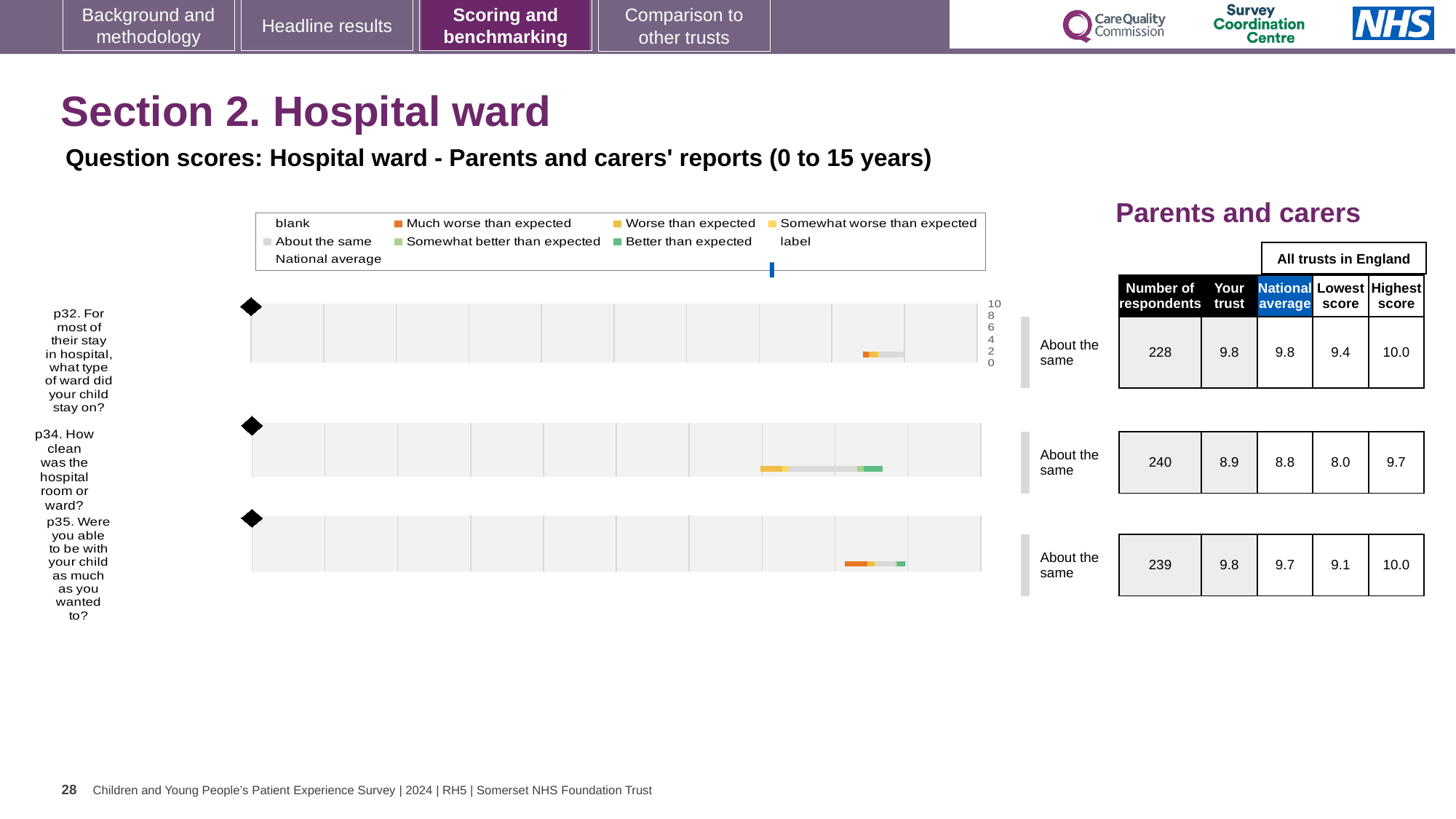
What is the highest score across all trusts in England for p34? 9.7 What is the national average score for p35 (Were you able to be with your child as much as you wanted to?)? 9.7 What is the difference between the highest score and the lowest score for p34? 1.7 What is the 'Your trust' score for p34 (How clean was the hospital room or ward?)? 8.9 What benchmark category is shown next to each of the three questions? About the same What kind of chart is used to show the question scores on this slide? Bar chart How many survey questions are plotted on the slide? 3 What colour represents 'Much worse than expected' in the legend? Orange Which question has the largest number of respondents? p34 For p34, which is larger: the 'Your trust' score or the national average? Your trust What is the lowest score across all trusts in England for p32? 9.4 How many respondents are listed for p32 (For most of their stay in hospital, what type of ward did your child stay on?)? 228